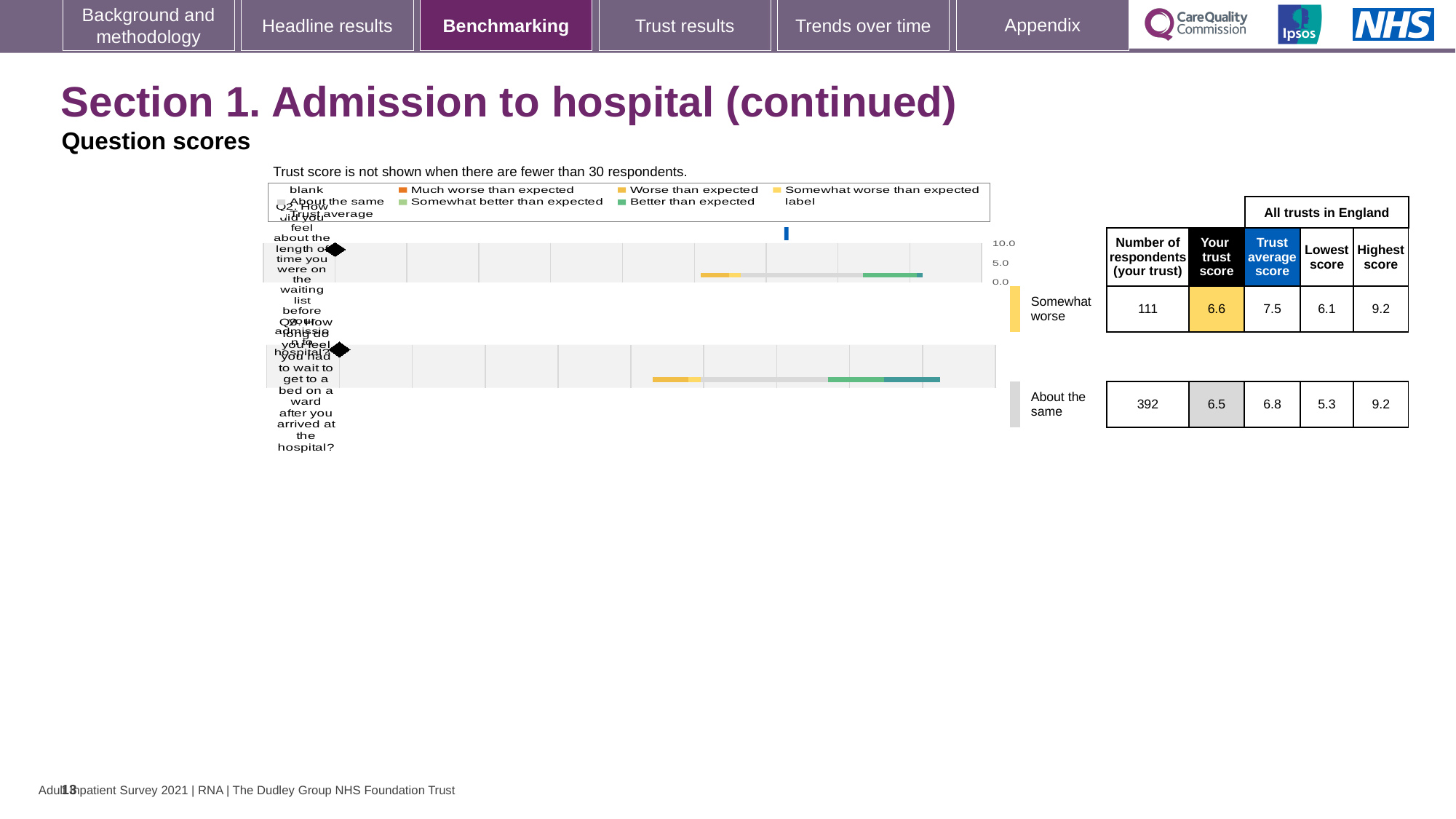
What kind of chart is shown on the slide? bar chart What is the lowest score across all trusts in England for Q3? 5.3 What is the trust score for Q3 (how long did you feel you had to wait to get to a bed on a ward)? 6.5 What is the trust average score for Q2? 7.5 How many respondents answered Q3 for this trust? 392 What is the difference between the trust average score and this trust's score for Q2? 0.9 What is the trust score for Q2 (how did you feel about the length of time on the waiting list)? 6.6 Which benchmarking category is the trust's Q3 score placed in? About the same Is the trust score for Q2 greater or less than 5.0? greater Which question had more respondents, Q2 or Q3? Q3 What is the highest score across all trusts in England for Q2? 9.2 How many questions are plotted in the chart? 2